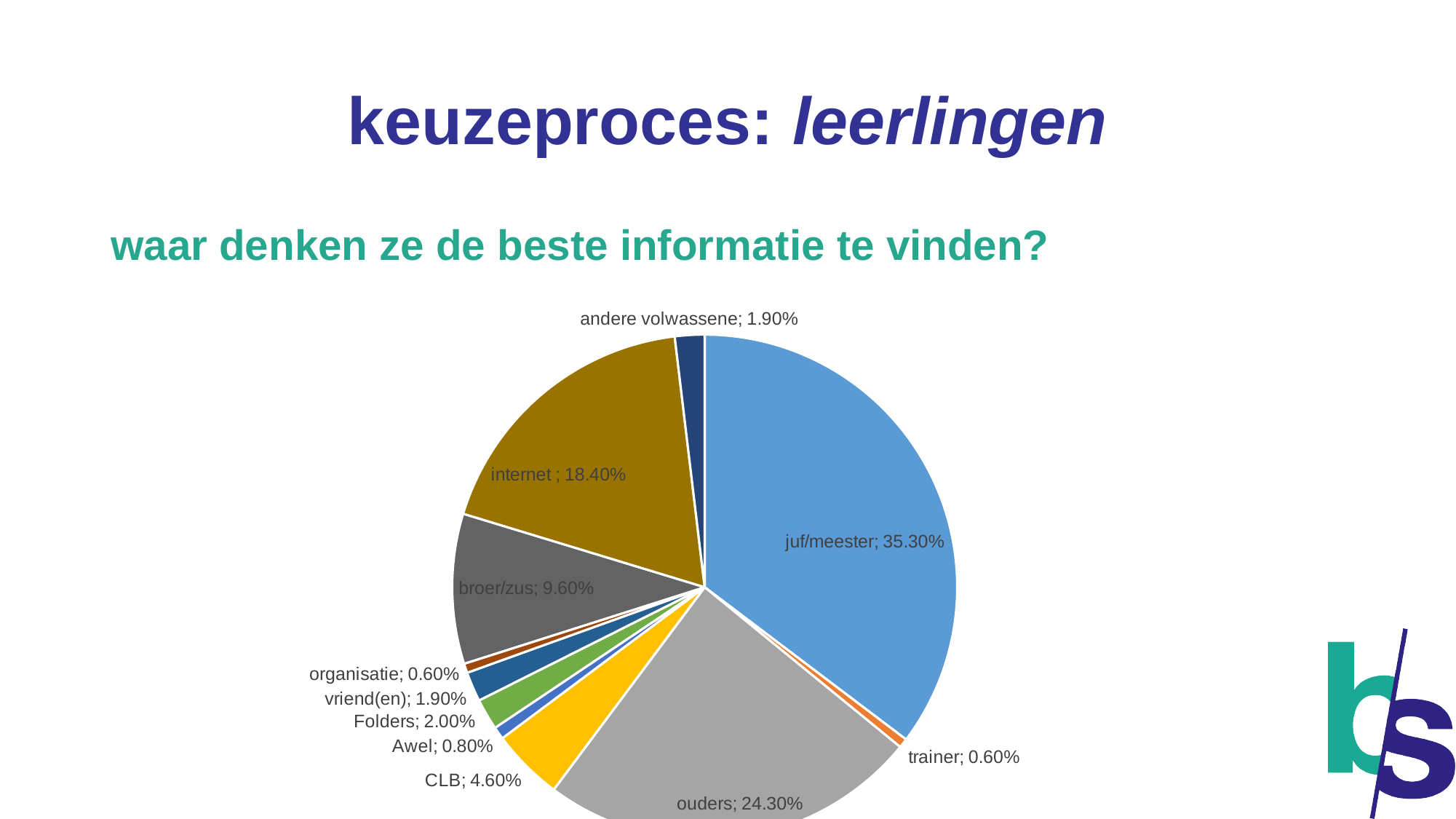
Which is larger, the slice for internet or the slice for broer/zus? internet What percentage is shown for juf/meester? 35.30% How many slices does the pie chart have? 11 What kind of chart is shown on the slide? pie chart What percentage is shown for ouders? 24.30% What percentage is shown for CLB? 4.60% What percentage is shown for Awel? 0.80% Which category has the largest slice of the pie? juf/meester What question is written in green above the chart? waar denken ze de beste informatie te vinden? What is the difference in percentage points between juf/meester and ouders? 11.00% What percentage is shown for broer/zus? 9.60% What percentage is shown for internet? 18.40%